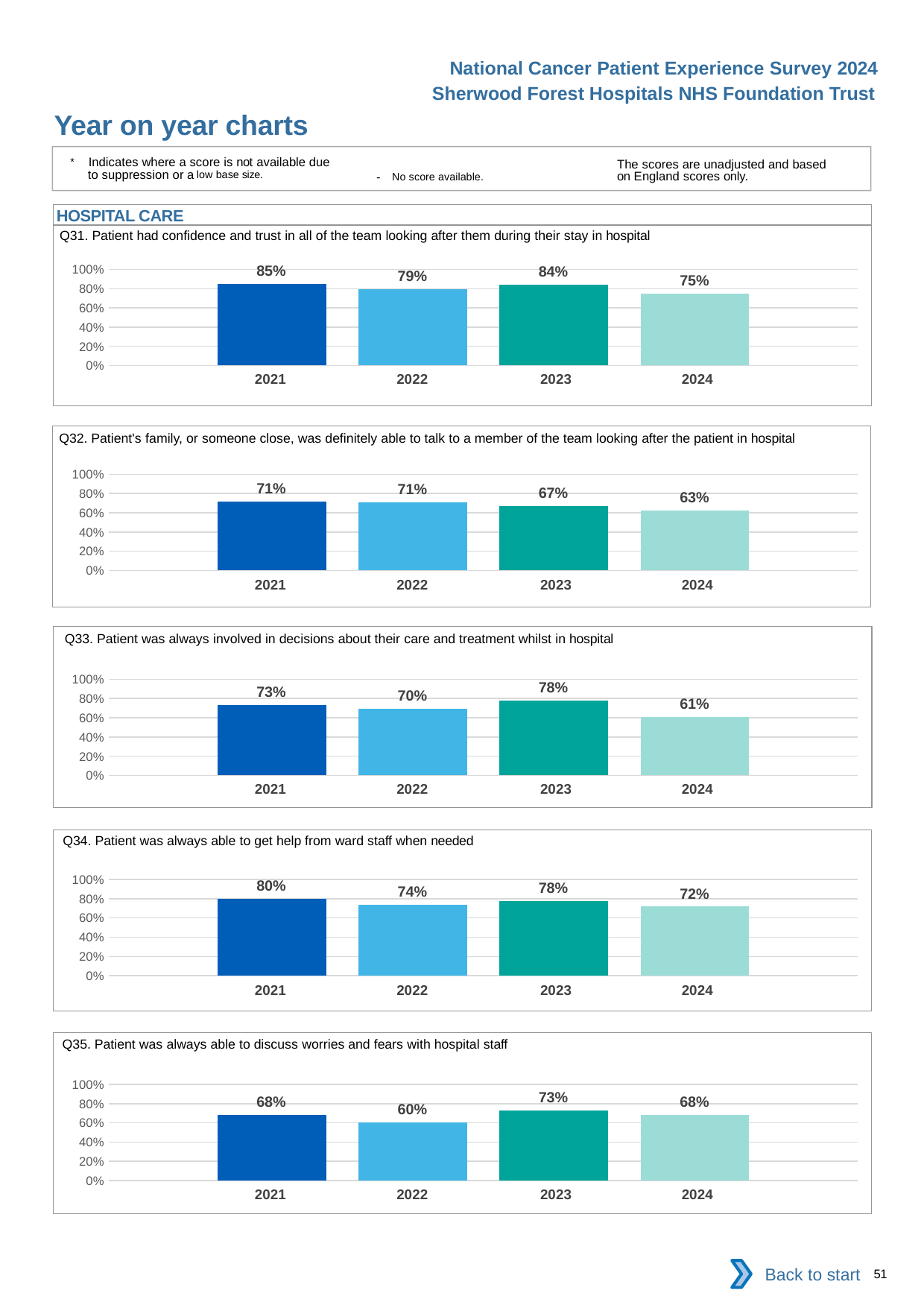
In the Q32 chart (patient's family was definitely able to talk to a member of the team), what is the value for 2023? 67% In the Q31 chart (patient had confidence and trust in all of the team), which year has the highest value? 2021 In the Q31 chart (patient had confidence and trust in all of the team), what is the value for 2024? 75% In the Q34 chart (patient was always able to get help from ward staff), what is the difference between the 2021 and 2022 values? 6% In the Q34 chart (patient was always able to get help from ward staff), which is larger, the value for 2022 or the value for 2023? 2023 In the Q33 chart (patient was always involved in decisions about their care), which year has the lowest value? 2024 How many years are shown on the x axis of the Q31 chart? 4 In the Q35 chart (patient was always able to discuss worries and fears), which year has the highest value? 2023 What kind of chart is the Q34 chart (patient was always able to get help from ward staff)? Bar chart In the Q32 chart (patient's family was definitely able to talk to a member of the team), what is the difference between the 2021 and 2024 values? 8% In the Q35 chart (patient was always able to discuss worries and fears), what is the value for 2022? 60% In the Q33 chart (patient was always involved in decisions about their care), what is the value for 2023? 78%